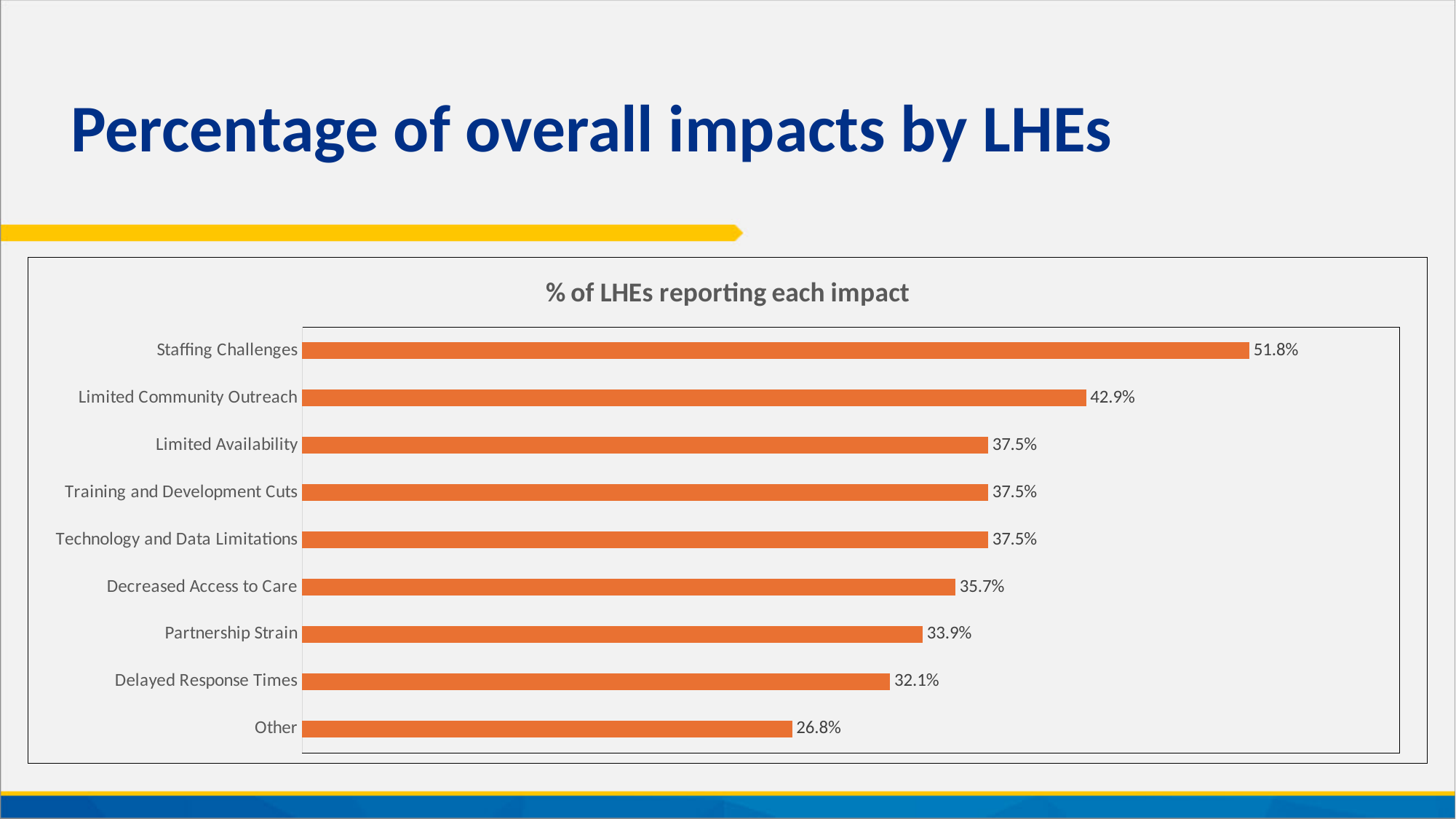
Which category has the lowest percentage in the chart? Other What percentage of LHEs reported Staffing Challenges? 51.8% What percentage of LHEs reported Partnership Strain? 33.9% How many categories share the value 37.5%? 3 What type of chart is shown on the slide? Bar chart Which is larger: the percentage for Limited Community Outreach or for Limited Availability? Limited Community Outreach What is the difference between the percentages for Decreased Access to Care and Other? 8.9% Which impact was reported by the highest percentage of LHEs? Staffing Challenges How many impact categories are shown in the chart? 9 What is the title of the chart? % of LHEs reporting each impact What percentage of LHEs reported Delayed Response Times? 32.1% What is the difference between the percentages for Staffing Challenges and Limited Community Outreach? 8.9%